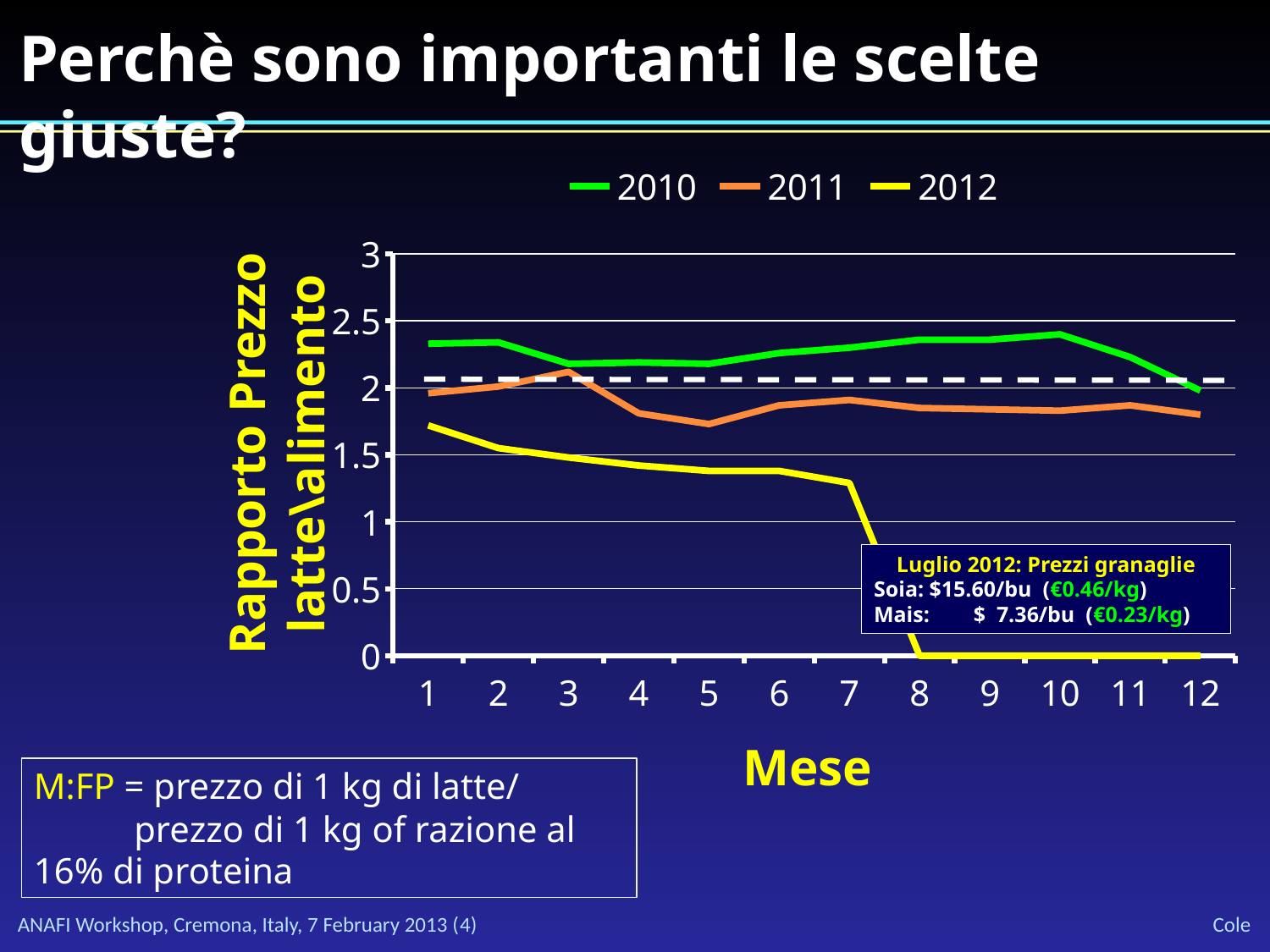
Is the value for 2010 in month 1 greater or less than 2? greater What kind of chart is shown on the slide? line chart Is the value for 2011 in month 5 greater or less than 2? less Is the value for 2010 in month 10 greater or less than 2.5? less In month 10, which series has the larger value, 2010 or 2011? 2010 How many series does the legend list? 3 In month 3, which series has the larger value, 2011 or 2012? 2011 How many months are shown along the x axis? 12 What is the title of the x axis? Mese Which series has the lowest value in month 12? 2012 Does the 2012 series rise or fall from month 1 to month 12? fall